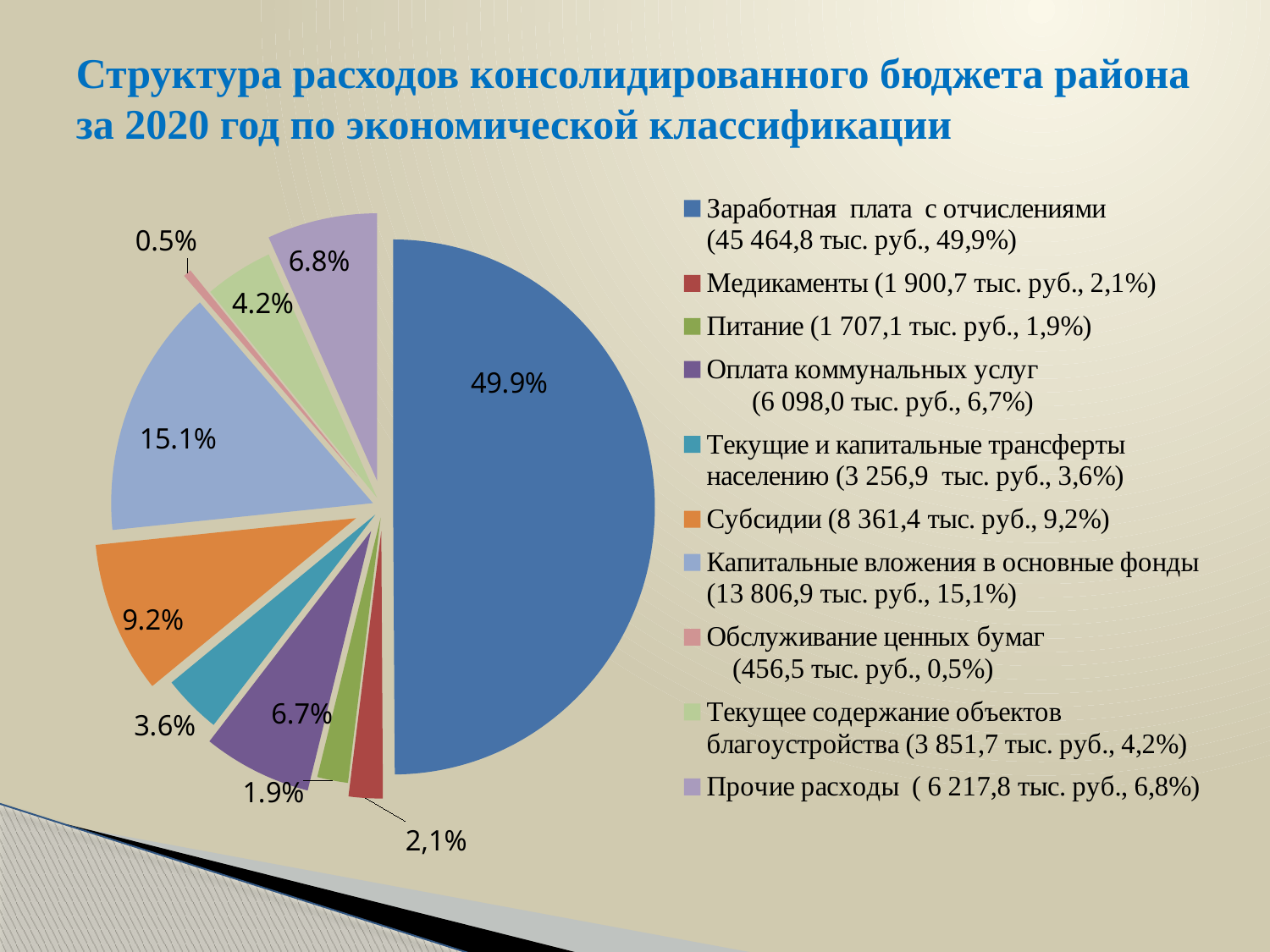
Which category has the largest slice of the pie? Заработная плата с отчислениями According to the legend, what amount in тыс. руб. corresponds to Медикаменты? 1 900,7 тыс. руб. How many entries does the legend list? 10 What is the difference in percentage points between the Капитальные вложения в основные фонды slice and the Субсидии slice? 5.9 percentage points Which category has the smallest slice of the pie? Обслуживание ценных бумаг What share of the pie is labelled for Оплата коммунальных услуг? 6.7% What kind of chart is shown on the slide? Pie chart Which slice is larger: Субсидии or Прочие расходы? Субсидии What share of the pie is labelled for Капитальные вложения в основные фонды? 15.1% How many slices does the pie chart have? 10 What share of the pie is labelled for Заработная плата с отчислениями? 49.9% Which slice is larger: Медикаменты or Питание? Медикаменты